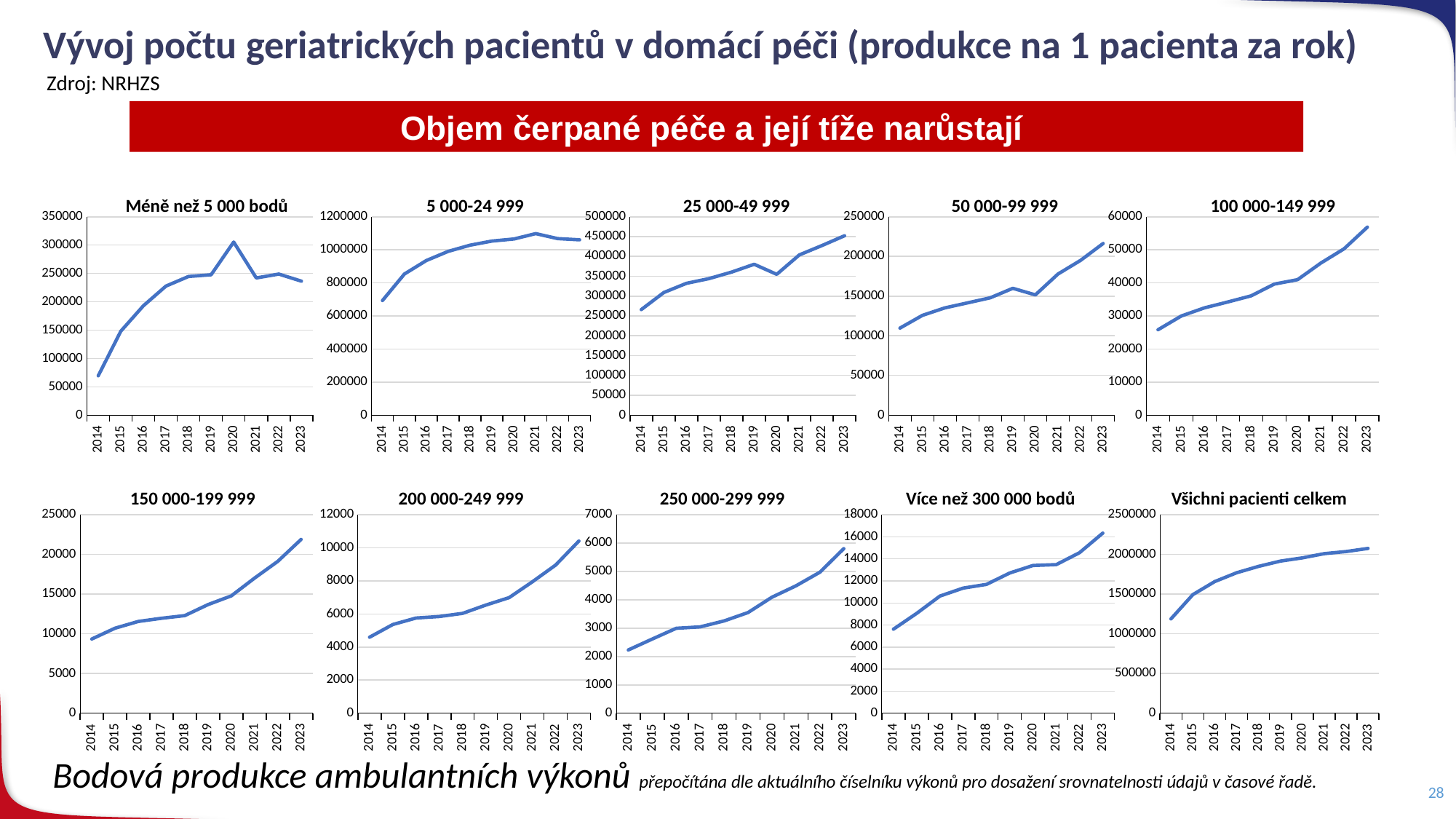
In the "Méně než 5 000 bodů" chart, which year has the highest value? 2020 In the "5 000-24 999" chart, is the value for 2023 greater or less than 1000000? greater In the "Všichni pacienti celkem" chart, do the values rise or fall from 2014 to 2023? rise In the "Méně než 5 000 bodů" chart, which year has the lowest value? 2014 In the "100 000-149 999" chart, is the value for 2023 greater or less than 50000? greater In the "Méně než 5 000 bodů" chart, is the value for 2014 greater or less than 100000? less How many charts are shown on the slide? 10 In the "Více než 300 000 bodů" chart, which year has the highest value? 2023 How many years are shown on the x axis of the "Všichni pacienti celkem" chart? 10 What kind of chart is the "Méně než 5 000 bodů" chart? line chart